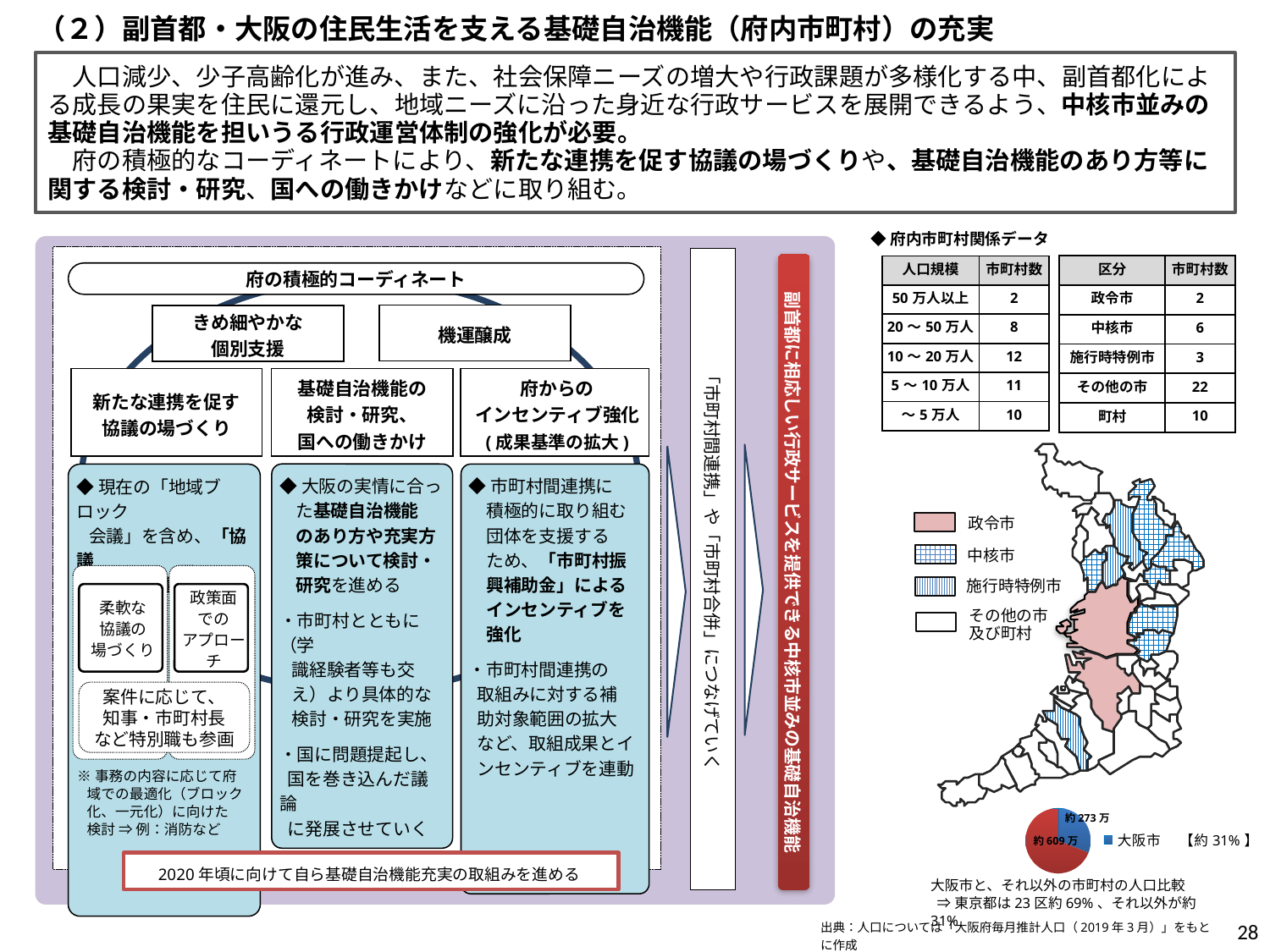
In the pie chart at the bottom right, which slice is the largest? the red slice (約609万, municipalities other than 大阪市) How many entries does the legend of the pie chart at the bottom right list? 1 In the pie chart at the bottom right, which slice is the smallest? 大阪市 In the pie chart at the bottom right, what value is printed for the red slice (municipalities other than 大阪市)? 約609万 In the pie chart at the bottom right, what share of the total does 大阪市 account for, as printed next to the chart? 約31% What colour is the 大阪市 slice in the pie chart at the bottom right? blue What kind of chart is shown at the bottom right of the slide, below the map? pie chart In the pie chart at the bottom right, what value is printed for the 大阪市 slice? 約273万 How many slices does the pie chart at the bottom right have? 2 What does the caption below the pie chart at the bottom right say the chart compares? 大阪市と、それ以外の市町村の人口比較 In the pie chart at the bottom right, which slice is larger: 大阪市 (約273万) or the other municipalities (約609万)? the other municipalities (約609万)